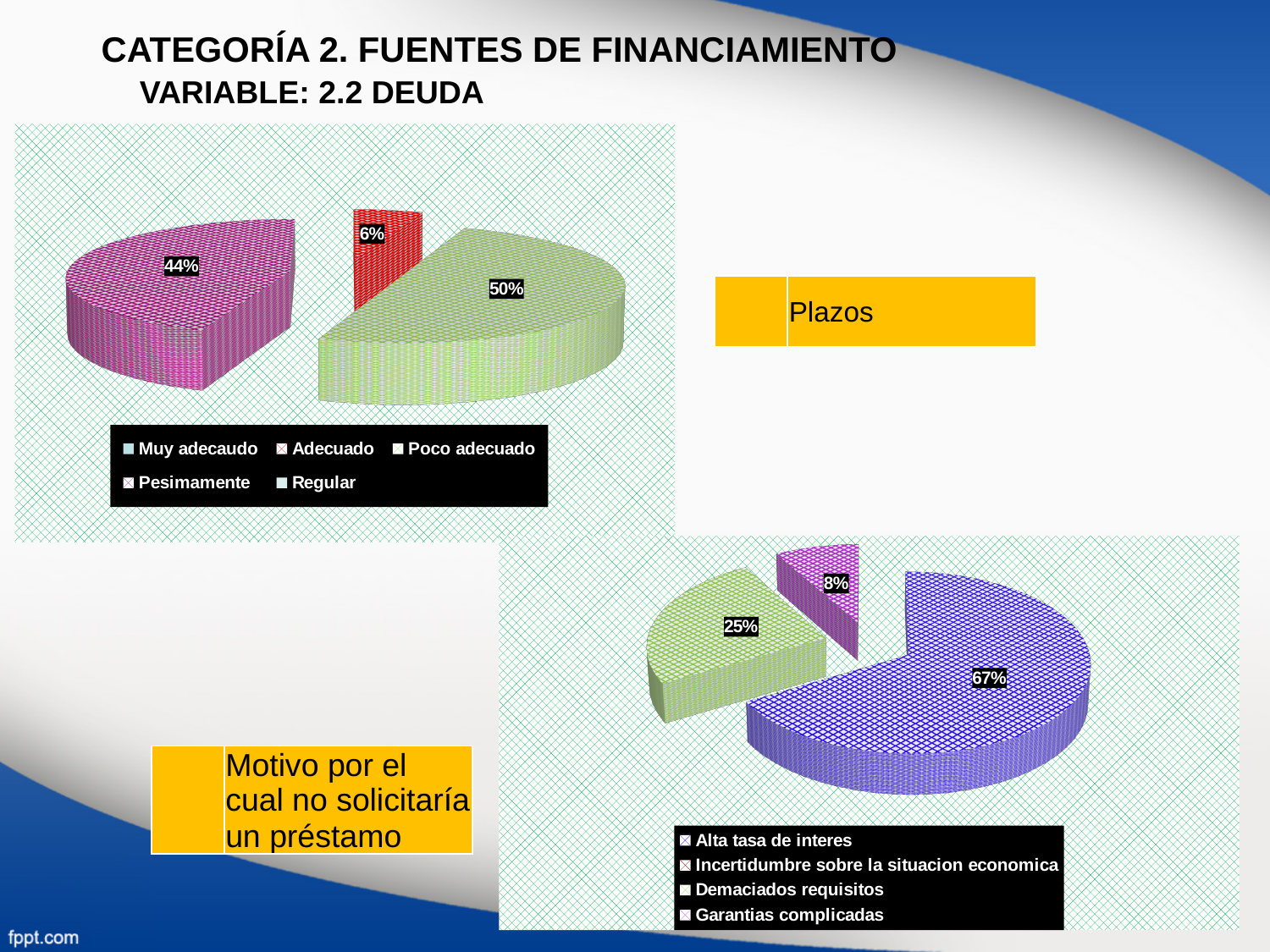
What kind of chart is the 'Plazos' chart? pie chart How many entries does the legend of the 'Motivo por el cual no solicitaría un préstamo' chart list? 4 In the 'Motivo por el cual no solicitaría un préstamo' chart, what is the largest slice's share? 67% In the 'Plazos' chart, what is the largest slice's share? 50% In the 'Plazos' chart, how many slices are labelled with a percentage? 3 In the 'Motivo por el cual no solicitaría un préstamo' chart, which is larger: the green slice or the magenta slice? the green slice In the 'Motivo por el cual no solicitaría un préstamo' chart, what is the smallest slice's share? 8% In the 'Plazos' chart, what is the difference between the 50% slice and the 44% slice? 6% How many entries does the legend of the 'Plazos' chart list? 5 What kind of chart is the 'Motivo por el cual no solicitaría un préstamo' chart? pie chart In the 'Motivo por el cual no solicitaría un préstamo' chart, what is the difference between the 67% slice and the 25% slice? 42% In the 'Plazos' chart, what is the smallest slice's share? 6%